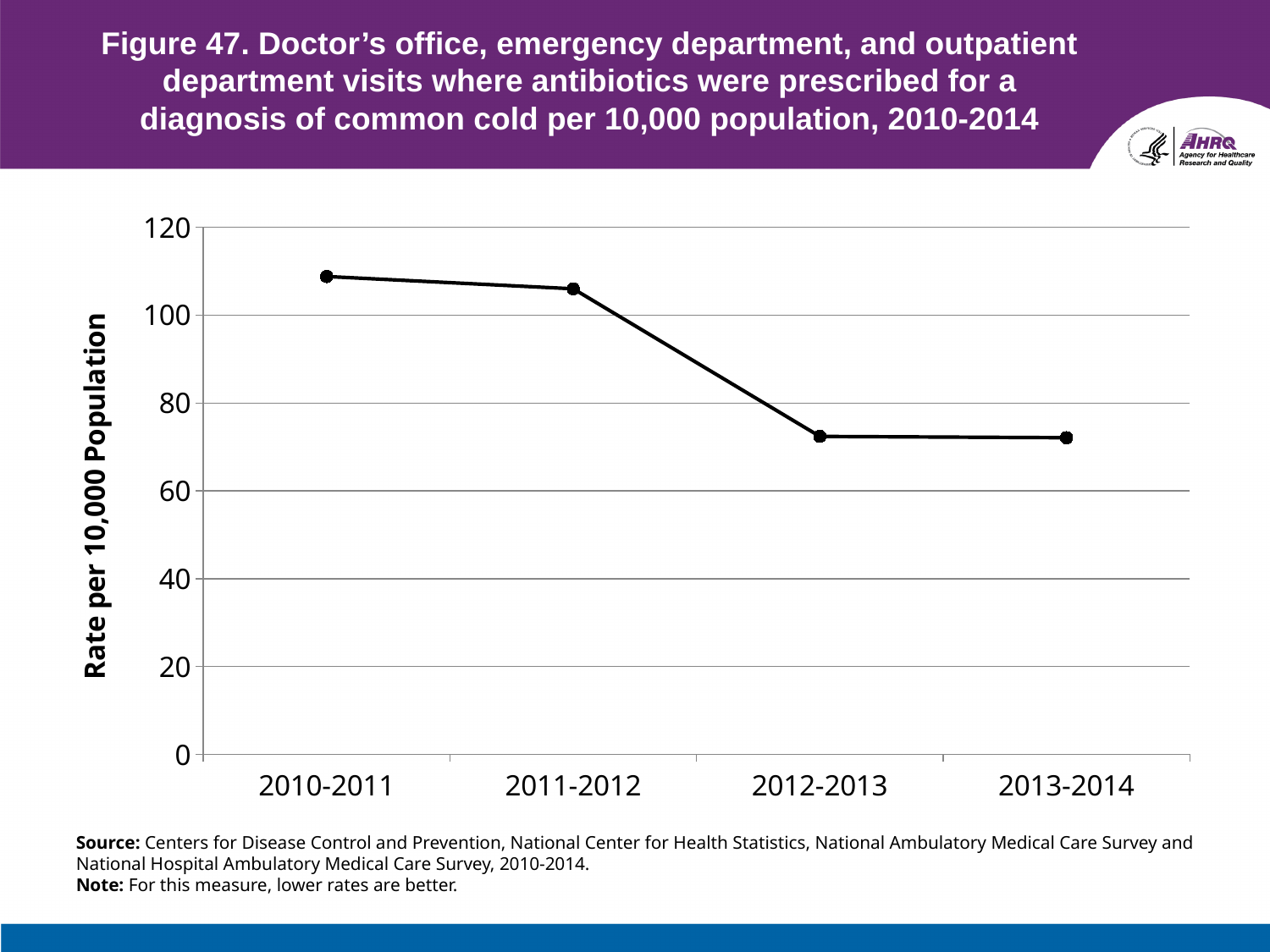
What is the label on the y axis? Rate per 10,000 Population What kind of chart is shown on the slide? line chart Do the values rise or fall from 2010-2011 to 2013-2014? fall Is the value for 2013-2014 greater or less than 60? greater Is the value for 2010-2011 greater or less than 100? greater How many time periods are plotted along the x axis? 4 Which is larger, the value for 2011-2012 or the value for 2012-2013? 2011-2012 Is the value for 2010-2011 greater or less than 120? less What is the first x-axis category label? 2010-2011 Which period has the highest rate? 2010-2011